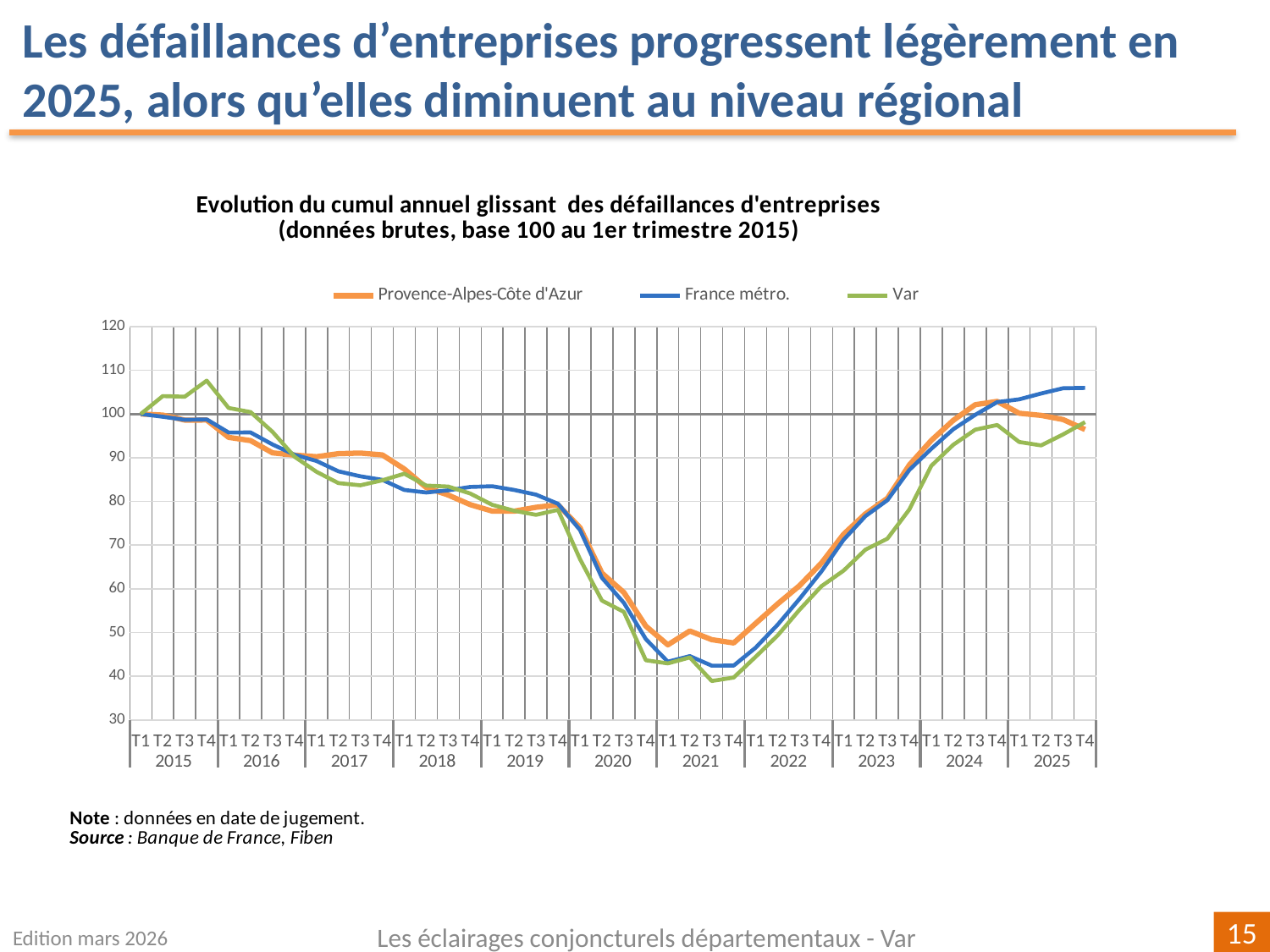
Is the value for Provence-Alpes-Côte d'Azur at T4 2025 greater or less than 100? less Which series has the highest value at T4 2025? France métro. Which colour is used for the Var series? green Is the value for Var at T4 2015 greater or less than 100? greater Is the value for France métro. at T4 2021 greater or less than 50? less What is the value of all three series at T1 2015? 100 What kind of chart is shown on the slide? line chart How many series does the legend list? 3 Which series has the lowest value at T3 2021? Var Does the France métro. series rise or fall between T4 2021 and T4 2025? rise How many years are labelled along the x axis? 11